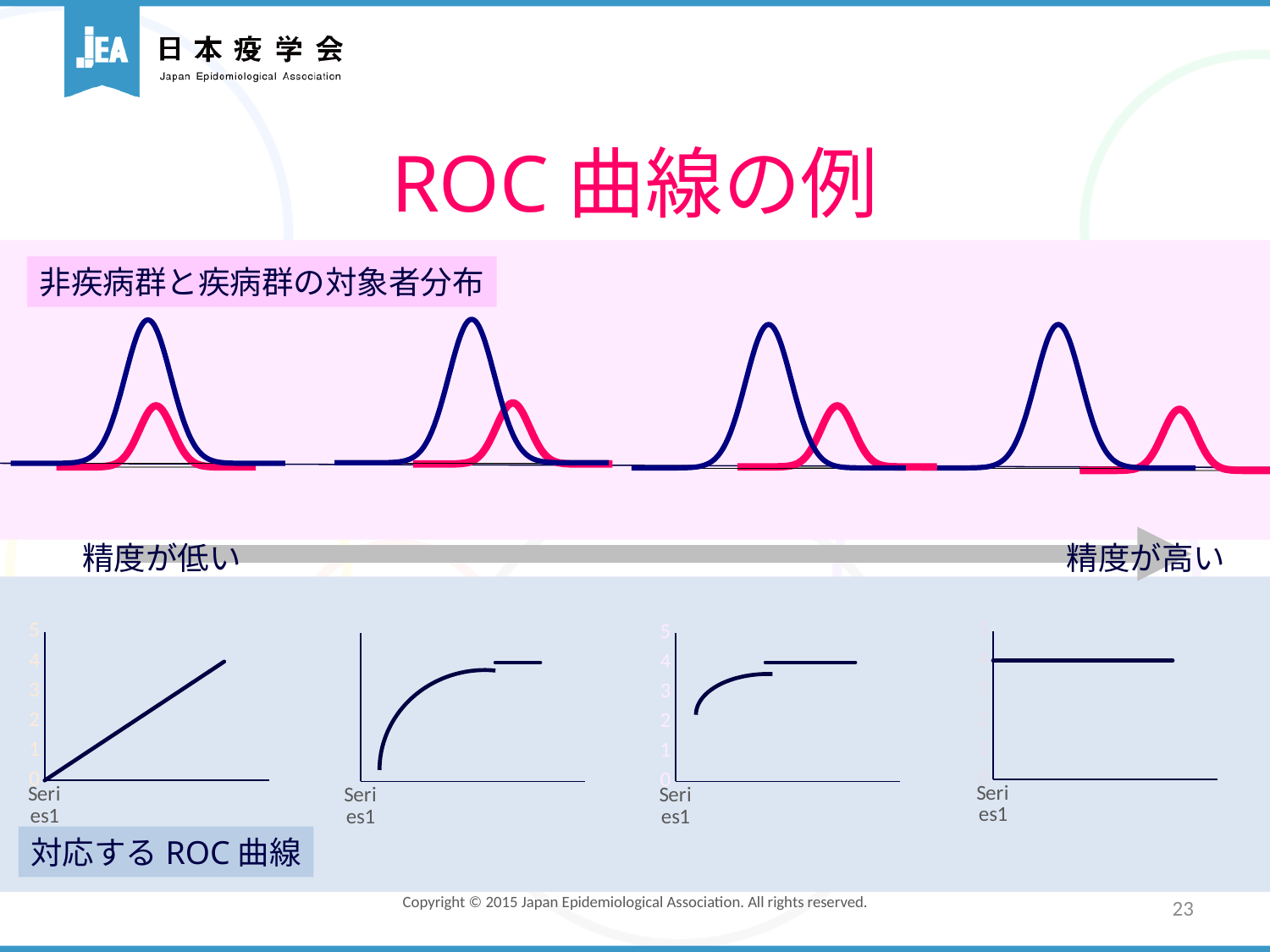
How many distribution panels (pairs of blue and red curves) are shown in the upper section of the slide? 4 What is the legend entry shown under each ROC curve chart? Series1 In the third ROC curve chart from the left, is the value at the left end of the curve greater or less than 1? greater What is the title of the slide containing the ROC curve charts? ROC 曲線の例 What kind of chart is the leftmost chart in the bottom row (the first ROC curve)? line chart How many ROC curve charts are shown in the bottom row of the slide? 4 In the leftmost ROC curve chart, does the line rise or fall as it moves along the x axis? rises In the rightmost ROC curve chart, does the line rise, fall, or stay flat along the x axis? stays flat How many series does the legend of the leftmost ROC curve chart list? 1 In the leftmost ROC curve chart, is the value at the left end of the line greater or less than 2? less In the leftmost ROC curve chart, is the value at the right end of the line greater or less than 3? greater